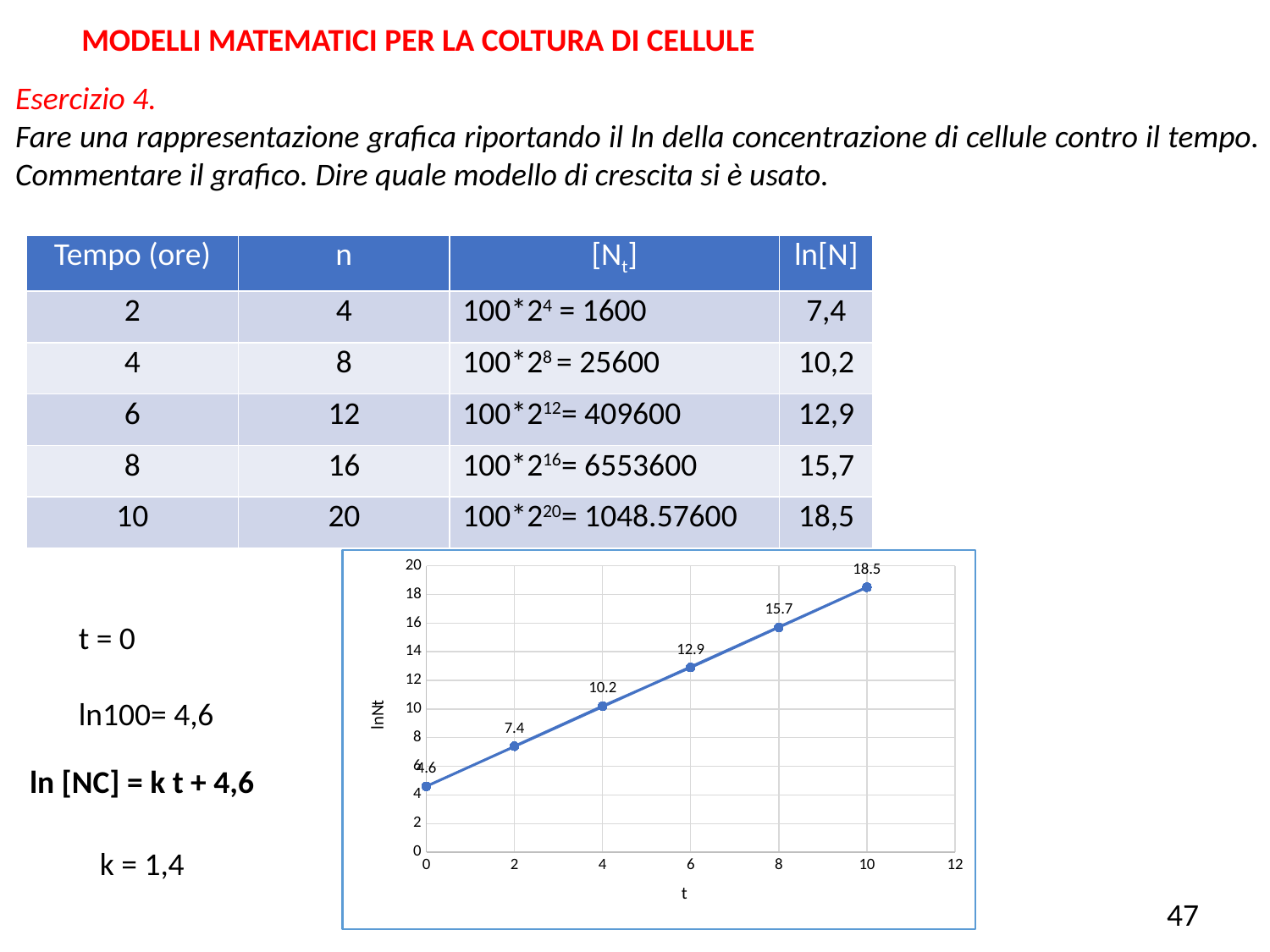
Is the value of lnNt at t = 6 greater or less than 14? less What kind of chart is shown on the slide? line chart What is the value of lnNt at t = 2? 7.4 At which value of t is lnNt lowest? 0 How many data points are plotted on the chart? 6 What is the value of lnNt at t = 10? 18.5 What is the difference between the lnNt values at t = 8 and t = 4? 5.5 What is the value of lnNt at t = 6? 12.9 What is the value of lnNt at t = 0? 4.6 Do the lnNt values rise or fall as t increases? rise At which value of t is lnNt highest? 10 Which is larger, the lnNt value at t = 4 or at t = 8? t = 8